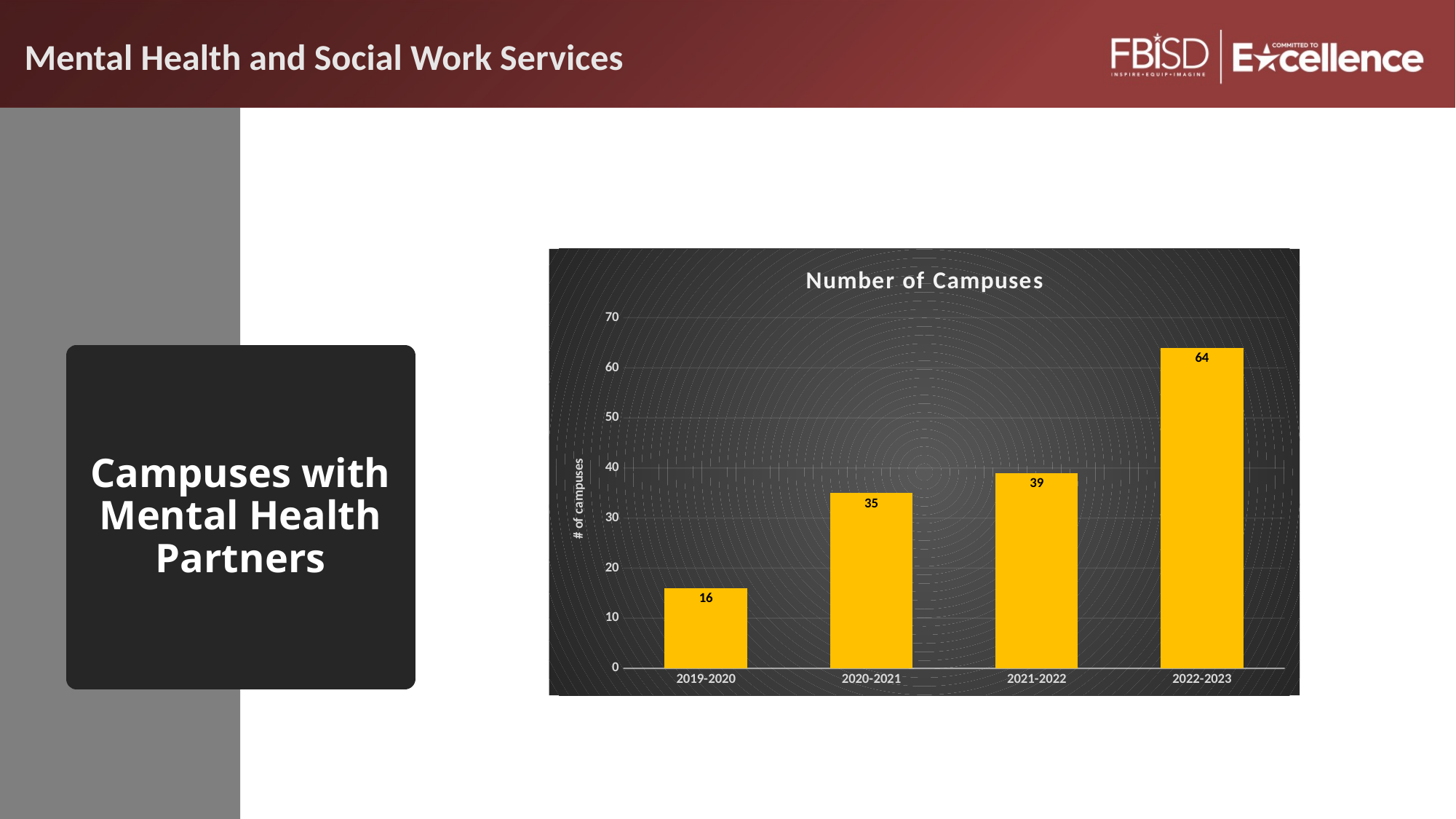
What is the difference in the number of campuses between 2022-2023 and 2021-2022? 25 What is the number of campuses for 2020-2021? 35 What kind of chart is shown on the slide? Bar chart What is the number of campuses for 2021-2022? 39 What is the number of campuses for 2019-2020? 16 Which school year has the lowest number of campuses? 2019-2020 Which school year has the highest number of campuses? 2022-2023 What is the difference in the number of campuses between 2020-2021 and 2019-2020? 19 Which has more campuses, 2020-2021 or 2021-2022? 2021-2022 What is the number of campuses for 2022-2023? 64 How many school years are shown on the chart? 4 Does the number of campuses rise or fall from 2019-2020 to 2022-2023? Rise